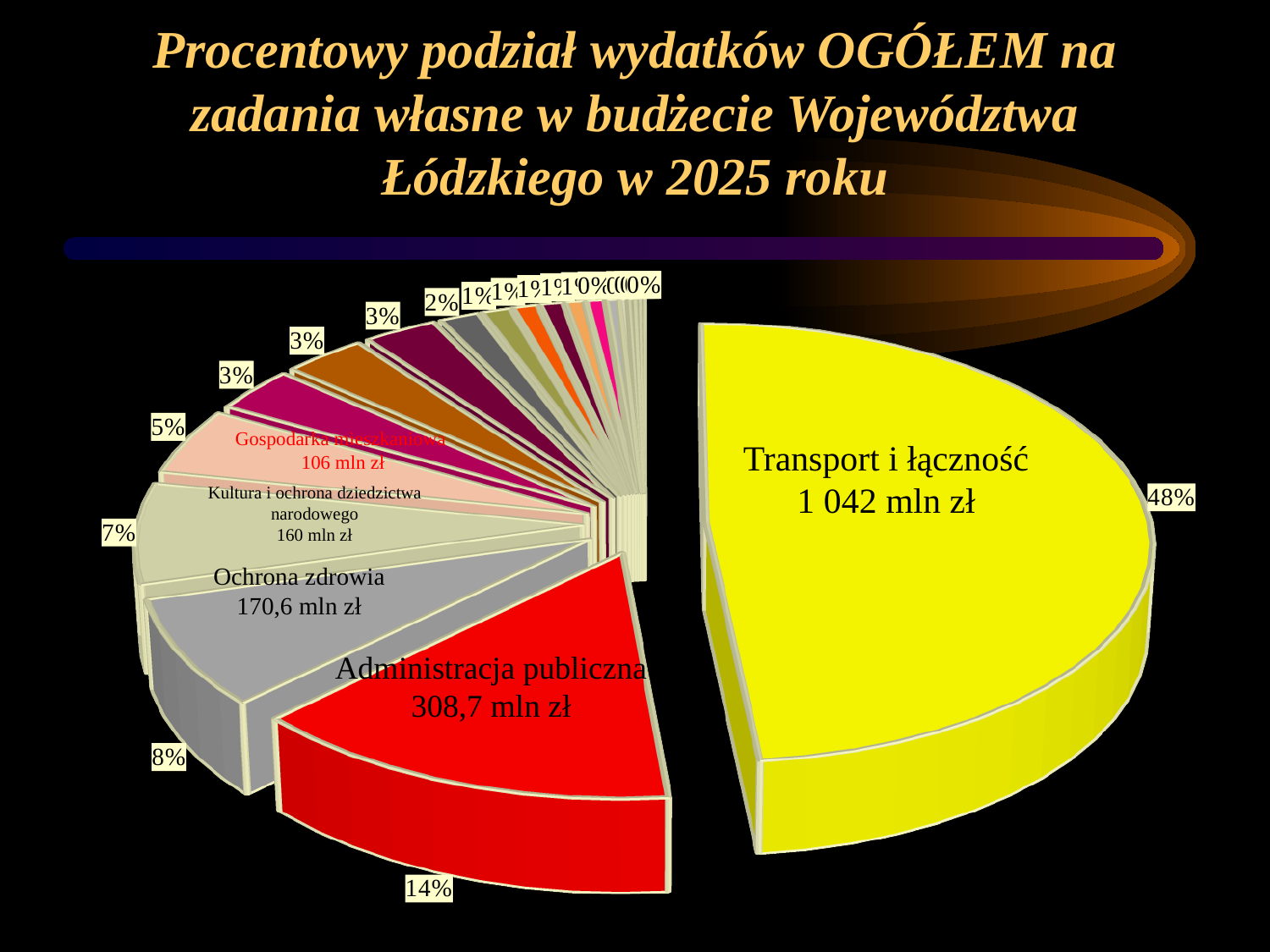
What is the difference in percentage points between the Transport i łączność share and the Administracja publiczna share? 34 percentage points Which is larger, the slice for Ochrona zdrowia or the slice for Kultura i ochrona dziedzictwa narodowego? Ochrona zdrowia What value is shown for Administracja publiczna? 308,7 mln zł What share of the pie does Gospodarka mieszkaniowa represent? 5% What kind of chart is shown on the slide? pie chart What value is shown for Ochrona zdrowia? 170,6 mln zł What value is shown for Kultura i ochrona dziedzictwa narodowego? 160 mln zł What share of the pie does Ochrona zdrowia represent? 8% What share of the pie does Administracja publiczna represent? 14% What value is shown for Transport i łączność? 1 042 mln zł Which category has the largest slice of the pie? Transport i łączność